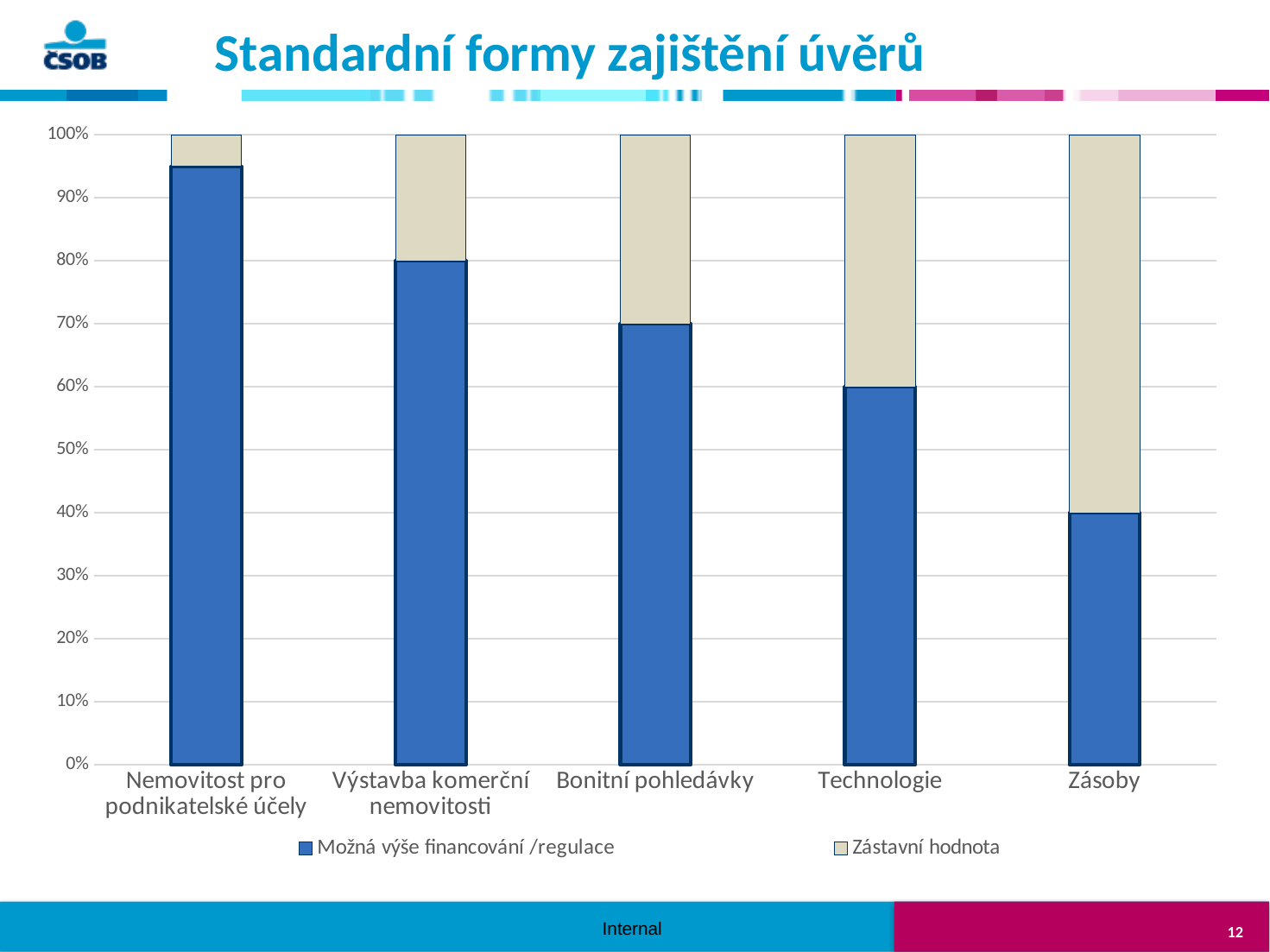
What is the value of 'Možná výše financování /regulace' for Zásoby? 40% What is the value of 'Možná výše financování /regulace' for Výstavba komerční nemovitosti? 80% Which category has the lowest value of 'Možná výše financování /regulace'? Zásoby What kind of chart is shown on the slide? stacked bar chart Does the 'Možná výše financování /regulace' series rise or fall from left to right along the x axis? fall Is the value of 'Možná výše financování /regulace' for Nemovitost pro podnikatelské účely greater or less than 90%? greater How many series does the legend list? 2 What is the value of 'Možná výše financování /regulace' for Technologie? 60% What is the value of 'Možná výše financování /regulace' for Bonitní pohledávky? 70% How many categories are shown on the x axis of the chart? 5 Which category has the highest value of 'Možná výše financování /regulace'? Nemovitost pro podnikatelské účely What is the difference between the 'Možná výše financování /regulace' values for Výstavba komerční nemovitosti and Zásoby? 40%